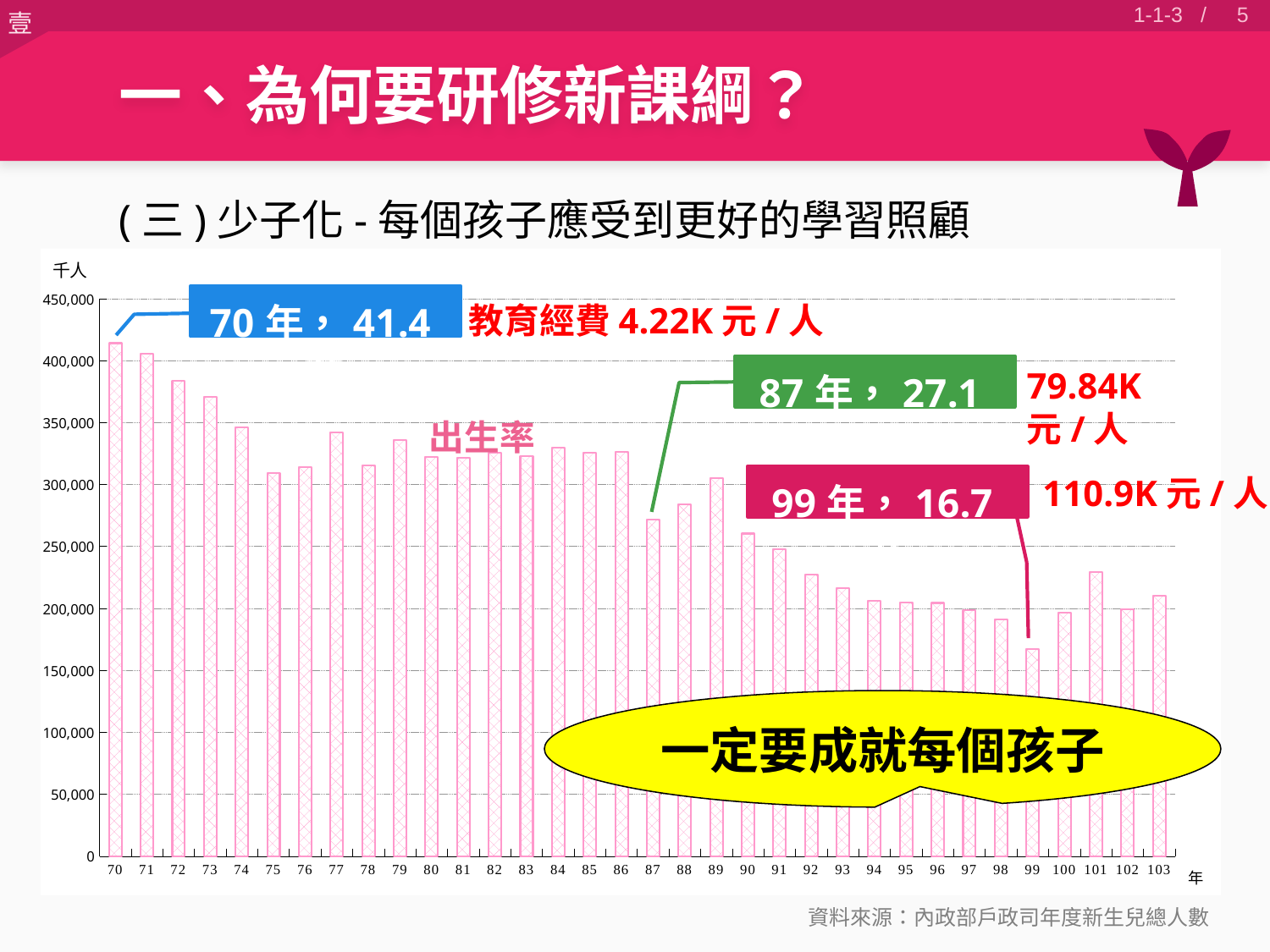
How many years (categories) are plotted along the x axis of the chart? 34 Is the value for year 99 greater or less than 200,000? less Is the value for year 70 greater or less than 400,000? greater What unit is shown at the top of the y axis? 千人 Overall, do the bar values rise or fall from year 70 to year 103? fall Which year has the highest bar in the chart? 70 What kind of chart is shown on the slide? bar chart Is the value for year 72 greater or less than 350,000? greater Which year has the lowest bar in the chart? 99 What value does the callout give for year 87? 27.1 Which year has the larger bar, year 101 or year 102? 101